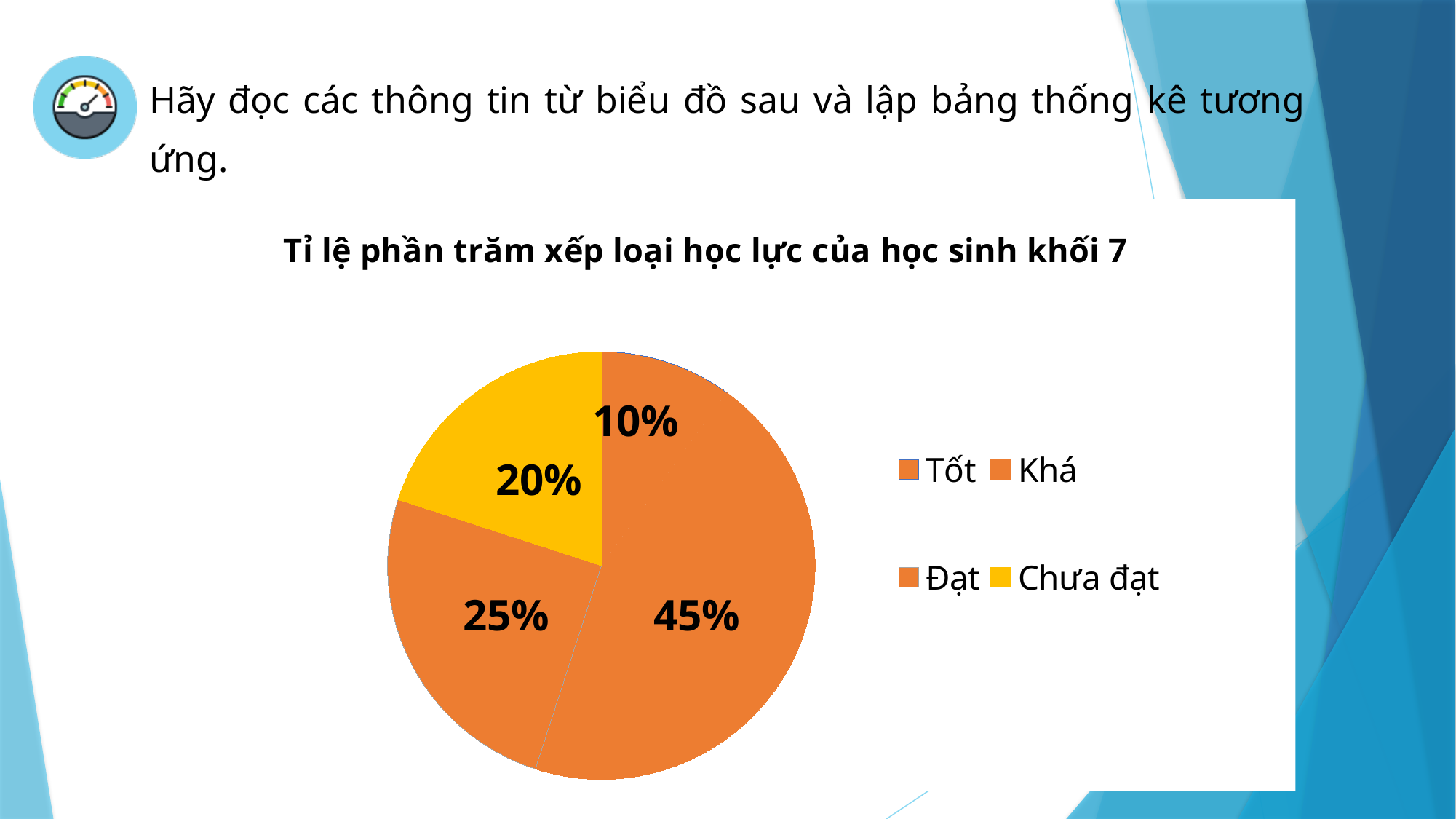
What percentage of the pie is labelled for Chưa đạt? 20% What type of chart is shown on the slide? pie chart What is the difference between the largest and smallest slice labels on the pie chart? 35% Which is larger: the Chưa đạt slice (20%) or the slice labelled 45%? the slice labelled 45% What is the title of the chart? Tỉ lệ phần trăm xếp loại học lực của học sinh khối 7 How many slices does the pie chart have? 4 How many categories does the legend of the pie chart list? 4 What is the largest percentage label shown on the pie chart? 45% What do the four slice labels on the pie chart add up to? 100% What is the smallest percentage label shown on the pie chart? 10% Which category is shown in yellow in the pie chart? Chưa đạt Is the share for Chưa đạt greater or less than 25%? less